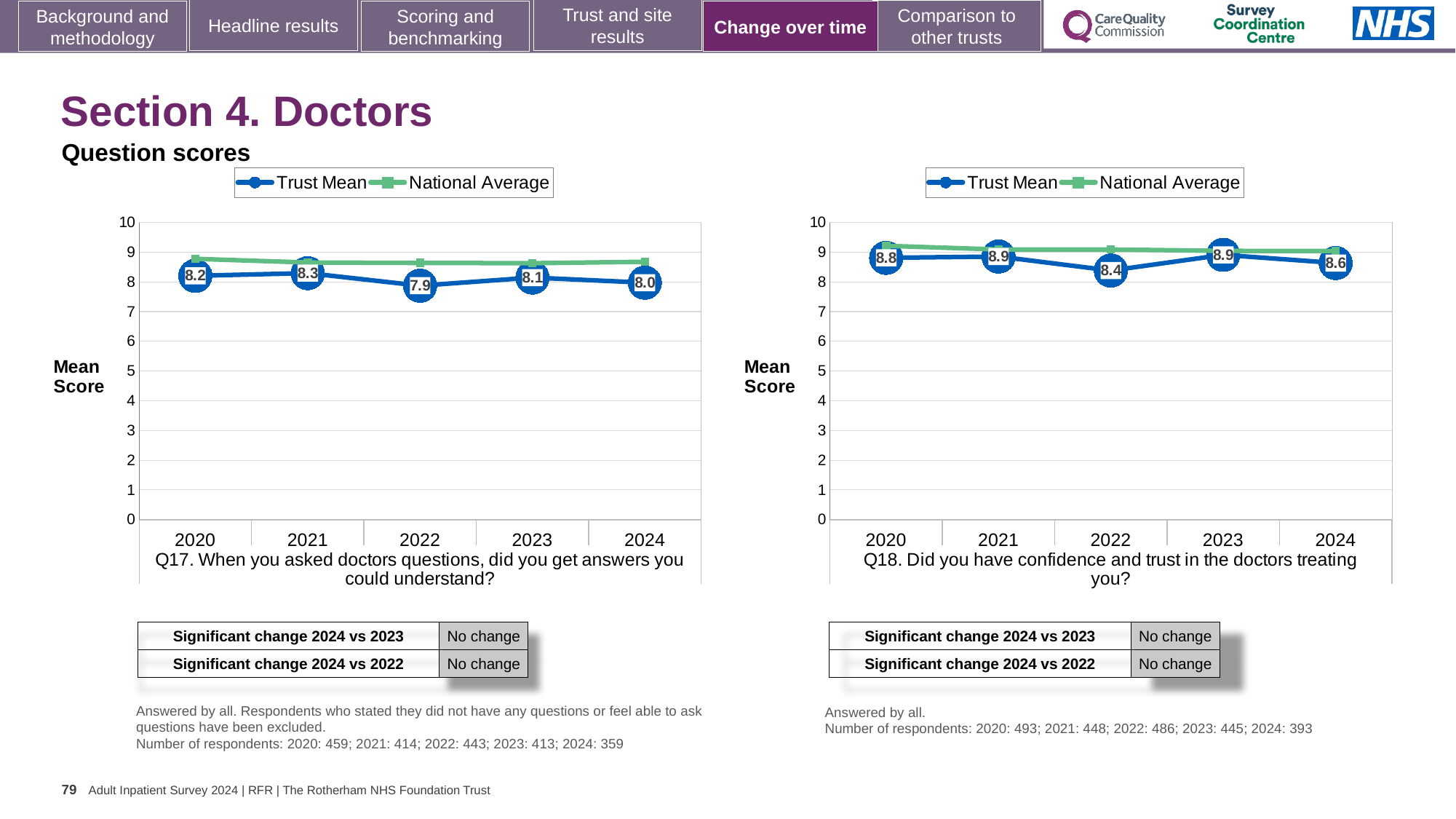
In the Q17 chart (left), what is the Trust Mean score for 2022? 7.9 In the Q18 chart (right), what is the difference between the Trust Mean scores for 2021 and 2022? 0.5 In the Q18 chart (right), which year has the lowest Trust Mean score? 2022 In the Q17 chart (left), is the Trust Mean score higher in 2020 or in 2024? 2020 In the Q17 chart (left), is the National Average for 2020 greater or less than 8? greater What is the y-axis label on the Q17 chart (left)? Mean Score How many years are plotted on the x axis of the Q18 chart (right)? 5 What type of chart is used for Q18 (right)? Line chart In the Q17 chart (left), which year has the highest Trust Mean score? 2021 How many series does the legend of the Q17 chart (left) list? 2 In the Q17 chart (left), does the Trust Mean rise or fall from 2023 to 2024? Fall In the Q18 chart (right), what is the Trust Mean score for 2024? 8.6